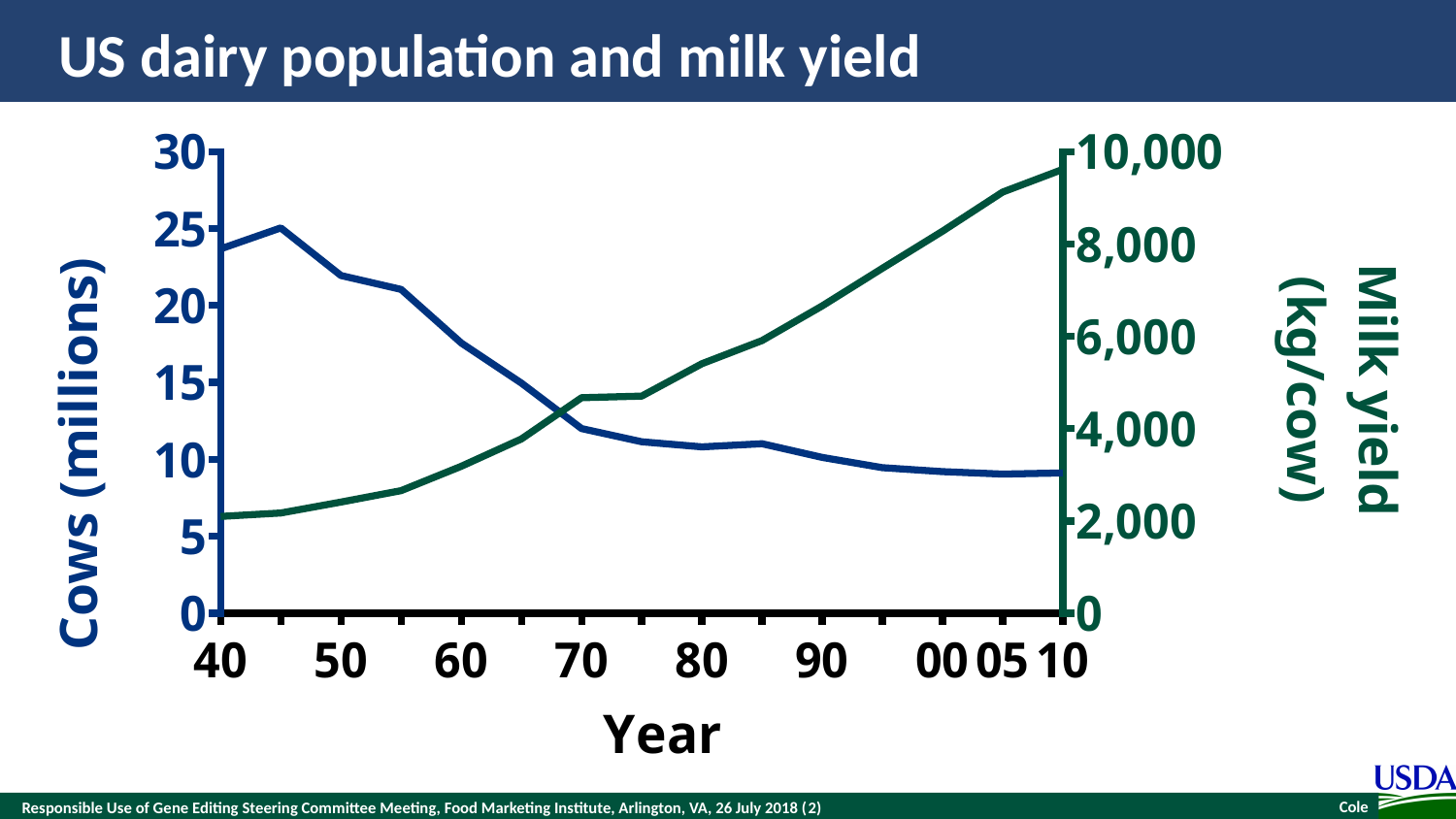
Is the value for Milk yield (kg/cow) in year 10 greater or less than 8,000? greater What is the label of the right-hand vertical axis? Milk yield (kg/cow) What kind of chart is shown on the slide? line chart In which year is milk yield (kg/cow) highest? 10 Is the value for Milk yield (kg/cow) in year 70 greater or less than 4,000? greater Does the Cows (millions) line rise or fall overall from 1940 to 2010? fall Is the value for Cows (millions) in year 10 greater or less than 10? less Which is larger, the number of cows in year 40 or in year 70? year 40 Does the Milk yield (kg/cow) line rise or fall overall from 1940 to 2010? rise What is the title of the chart? US dairy population and milk yield How many year labels are shown on the x axis? 9